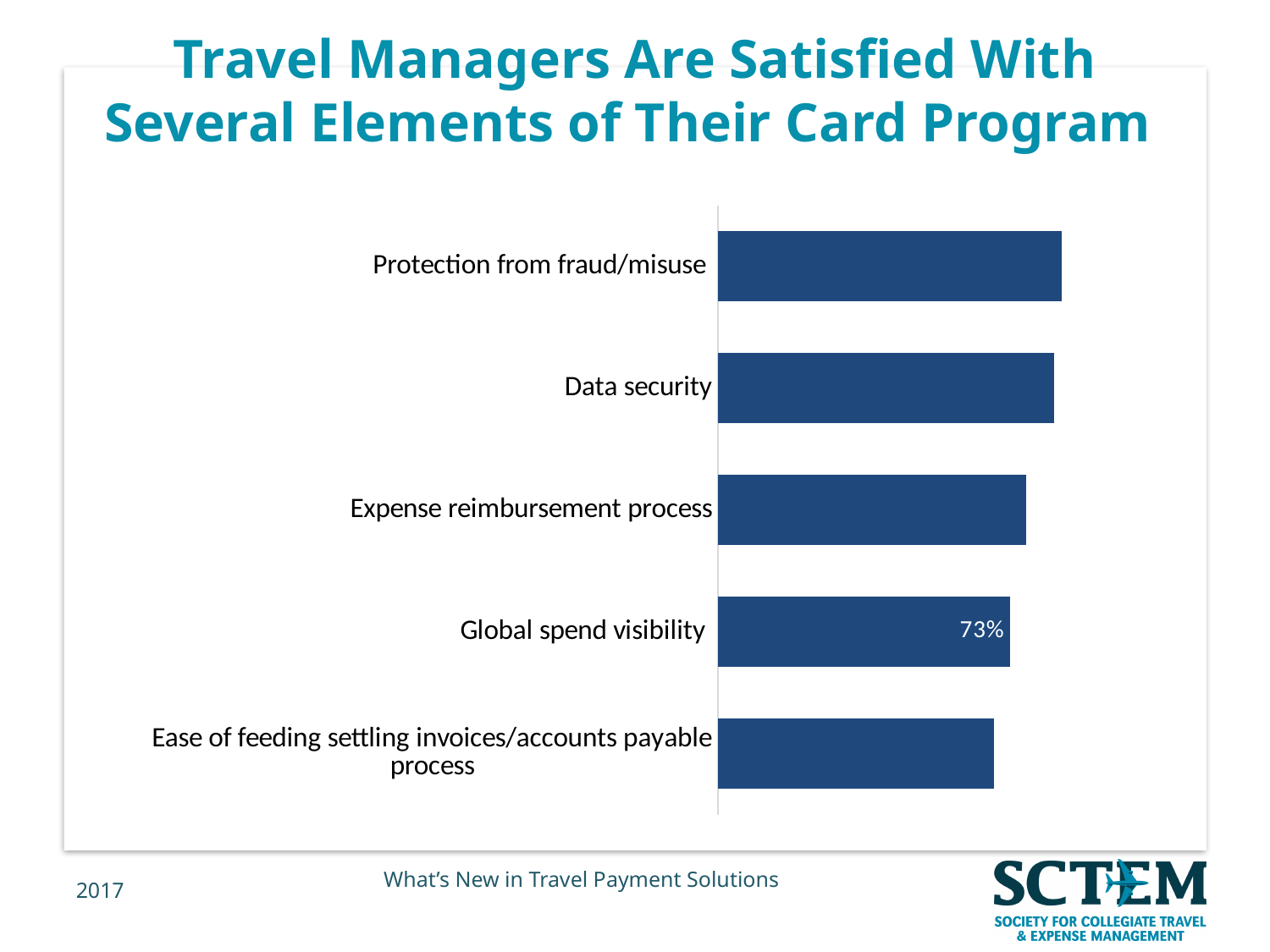
What kind of chart is shown on the slide? bar chart Which is larger, the value for Expense reimbursement process or the value for Ease of feeding settling invoices/accounts payable process? Expense reimbursement process Which category has the highest value? Protection from fraud/misuse Which is larger, the value for Data security or the value for Expense reimbursement process? Data security How many categories are shown in the chart? 5 What is the value shown for Global spend visibility? 73% Which category is listed at the top of the chart? Protection from fraud/misuse What is the title of the slide containing the chart? Travel Managers Are Satisfied With Several Elements of Their Card Program Which is larger, the value for Protection from fraud/misuse or the value for Global spend visibility? Protection from fraud/misuse Which category has the lowest value? Ease of feeding settling invoices/accounts payable process